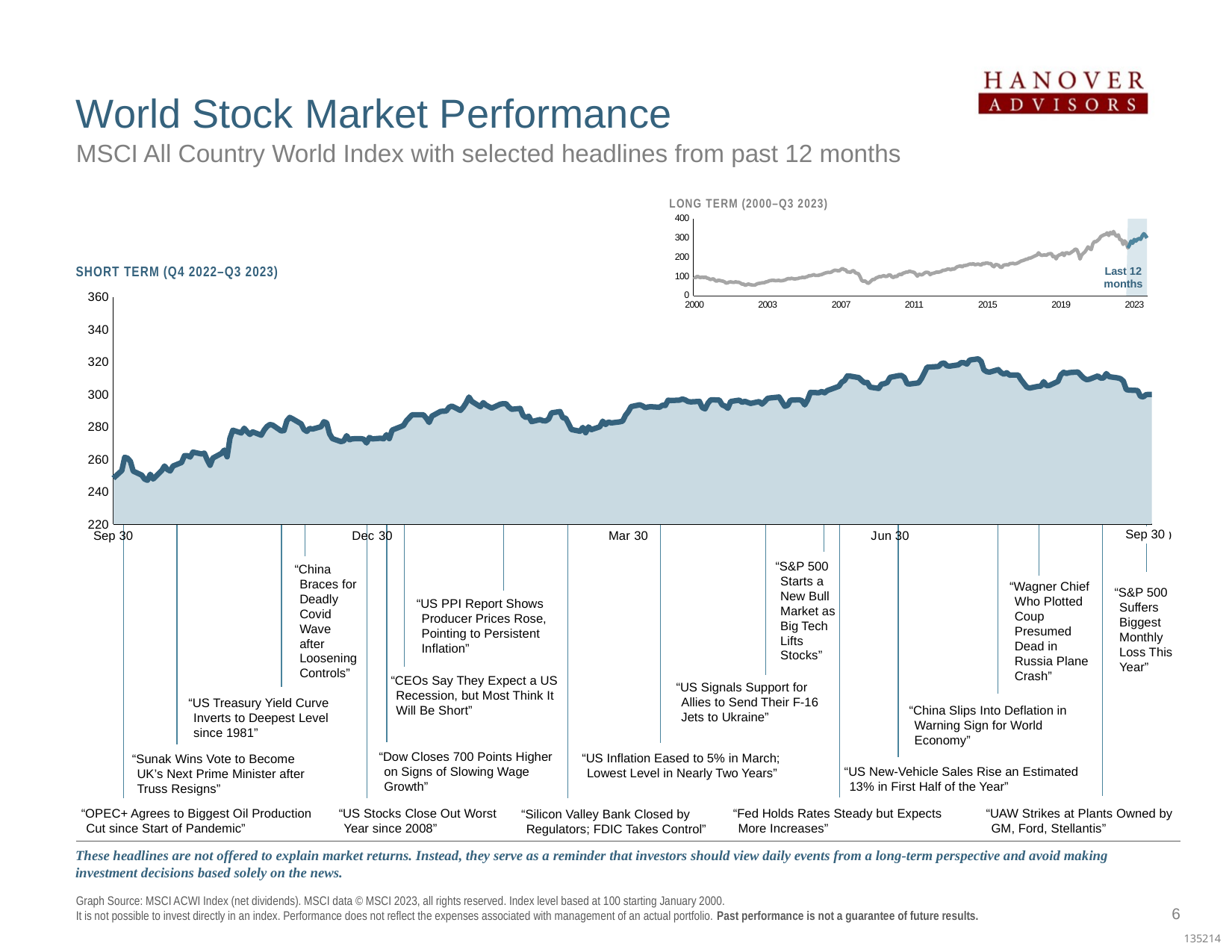
On the SHORT TERM chart, does the index end higher or lower at Sep 30 2023 than it started at Sep 30 2022? higher On the SHORT TERM chart, is the index value at Jun 30 greater or less than 300? greater What kind of chart is the SHORT TERM (Q4 2022–Q3 2023) chart? line chart On the SHORT TERM chart, does the highest point of the index occur before or after Jun 30? after On the SHORT TERM chart, is the index value at Dec 30 greater or less than 280? less On the SHORT TERM chart, is the index value at Sep 30 (the start of the chart) greater or less than 260? less What is the highest value shown on the y axis of the SHORT TERM chart? 360 On the LONG TERM (2000–Q3 2023) chart, does the index generally rise or fall from 2000 to 2023? rise How many date labels are shown on the x axis of the SHORT TERM chart? 5 What label is given to the shaded region at the right end of the LONG TERM chart? Last 12 months